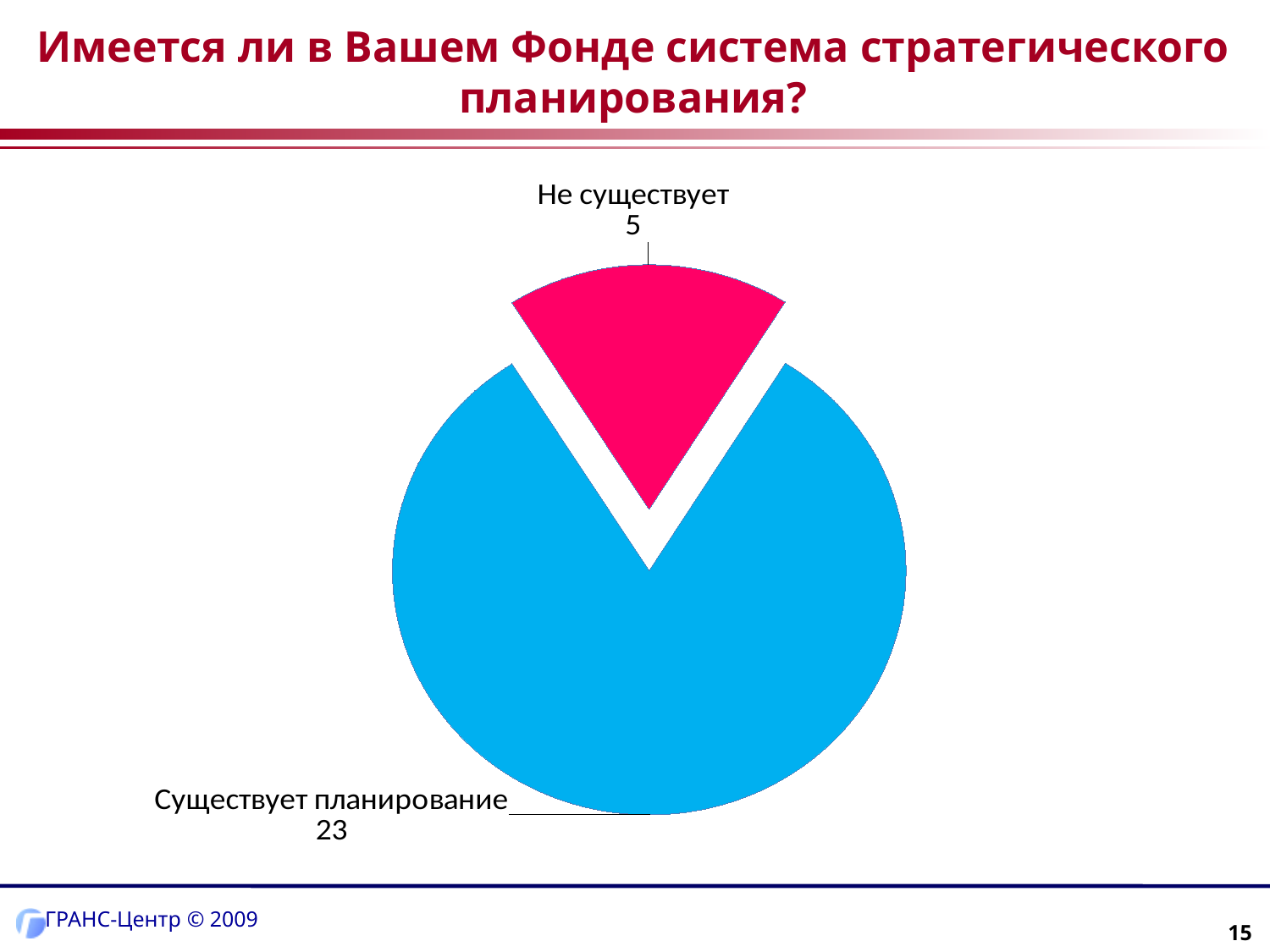
Which is larger, the value for "Существует планирование" or for "Не существует"? Существует планирование What is the value for "Не существует"? 5 What is the value for "Существует планирование"? 23 Which category has the smallest slice of the pie? Не существует What kind of chart is shown on the slide? pie chart What is the title of the slide containing the pie chart? Имеется ли в Вашем Фонде система стратегического планирования? Which category has the largest slice of the pie? Существует планирование What is the total of all slices in the pie chart? 28 What share of the total does the "Не существует" slice represent? 5 out of 28 How many slices does the pie chart have? 2 What colour is the "Не существует" slice? pink/red What is the difference between the values for "Существует планирование" and "Не существует"? 18